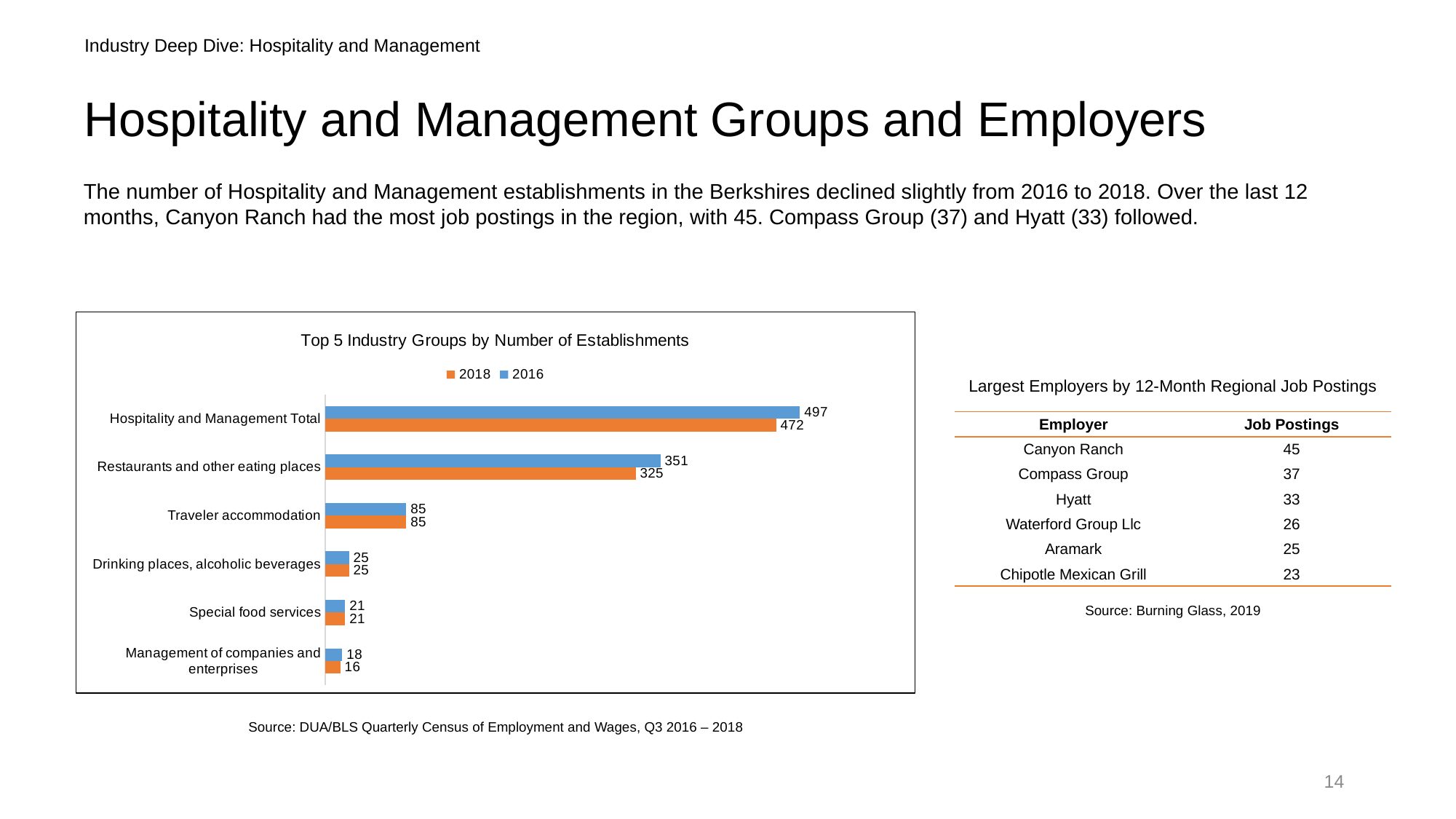
Excluding the total, which category has the highest 2016 value in the chart? Restaurants and other eating places What kind of chart is 'Top 5 Industry Groups by Number of Establishments'? bar chart Which category has the lowest 2018 value in the chart? Management of companies and enterprises In the chart, what is the 2018 value for Management of companies and enterprises? 16 In the chart, what is the difference between the 2016 and 2018 values for Hospitality and Management Total? 25 In the chart, what is the difference between the 2016 and 2018 values for Restaurants and other eating places? 26 In the chart, what is the 2016 value for Hospitality and Management Total? 497 In the chart, what is the 2016 value for Traveler accommodation? 85 In the chart, what is the 2018 value for Restaurants and other eating places? 325 How many categories are shown in the chart? 6 How many series does the chart's legend list? 2 In the chart, which colour represents the 2018 series? orange